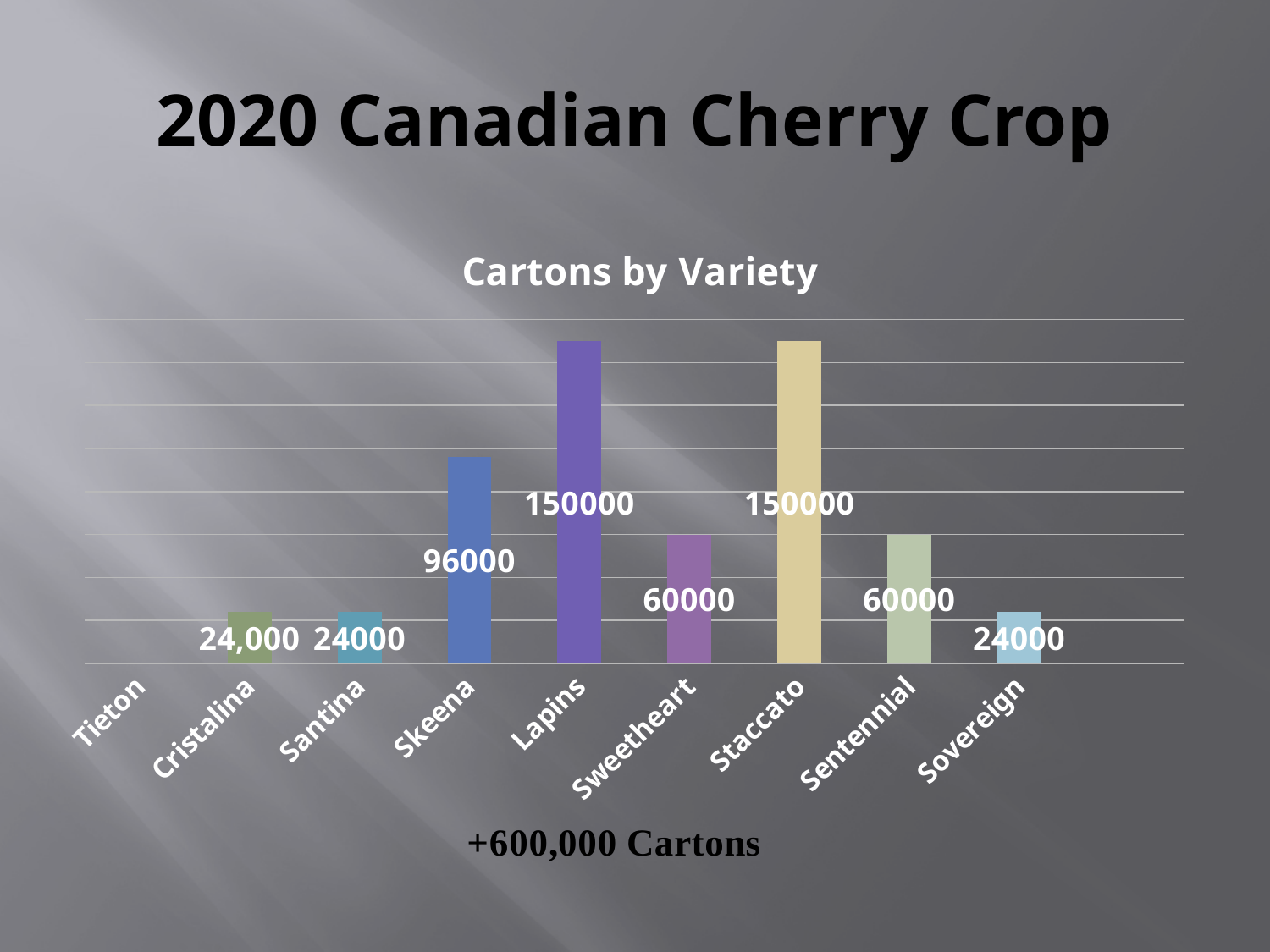
What is the value for Staccato? 150000 What is the value for Sweetheart? 60000 Which is larger, the value for Sentennial or the value for Sovereign? Sentennial What is the value for Sovereign? 24000 What is the value for Skeena in the Cartons by Variety chart? 96000 How many varieties are listed on the x axis of the chart? 9 What is the difference between the values for Skeena and Santina? 72000 What kind of chart is shown on the slide? Bar chart Which is larger, the value for Skeena or the value for Sweetheart? Skeena How many cartons are shown for Lapins? 150000 What is the difference between the values for Lapins and Skeena? 54000 What value is labelled for Cristalina? 24,000